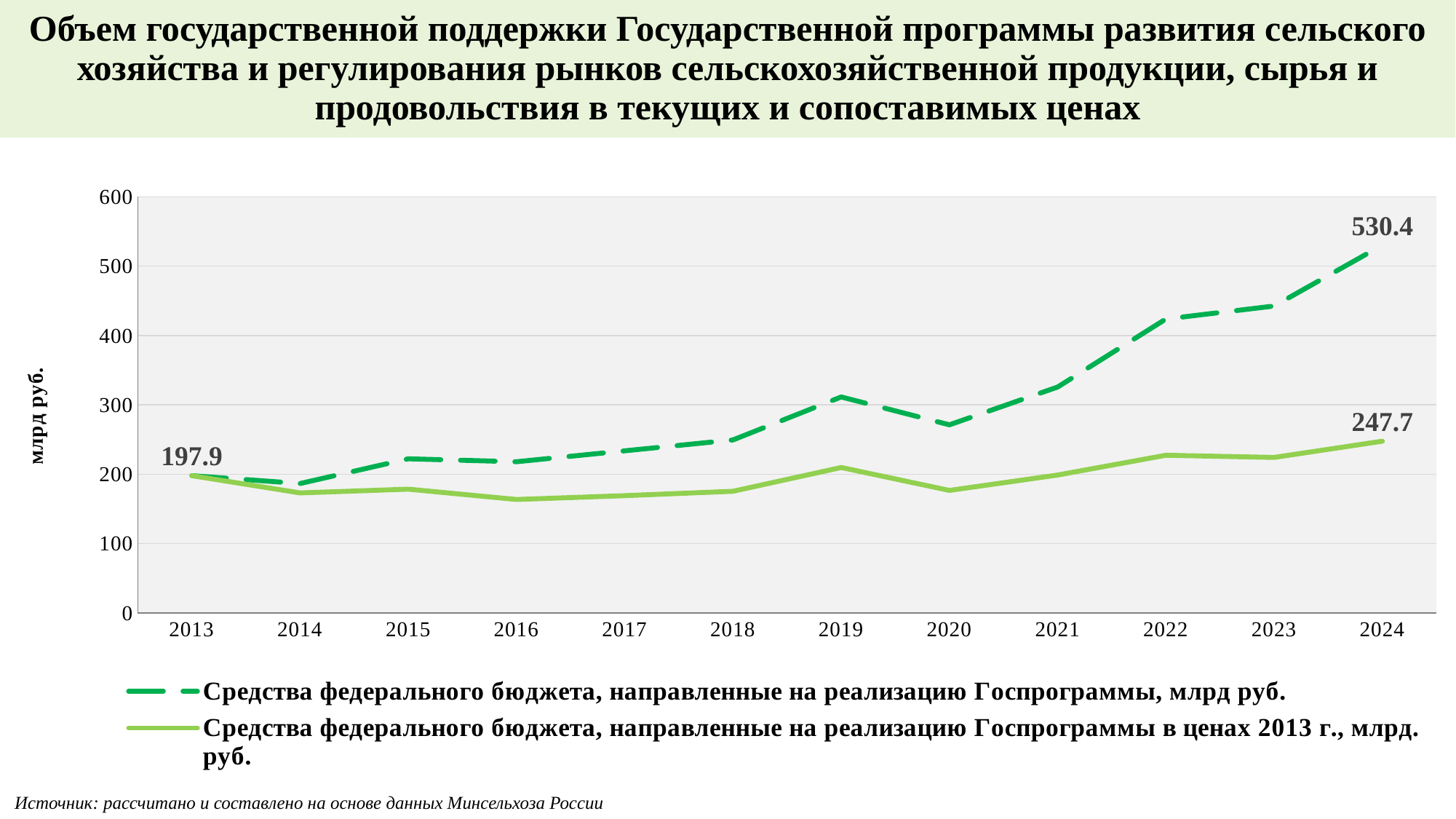
In which year does the dashed line (current prices) reach its highest value? 2024 By how much did the federal budget funds in current prices (dashed line) grow from 2013 to 2024? 332.5 What is the value of the federal budget funds in 2013 prices (solid line) in 2024? 247.7 What is the difference between the two series' values in 2024? 282.7 What is the value of the federal budget funds in current prices (dashed line) in 2024? 530.4 What is the label on the vertical axis? млрд руб. What kind of chart is shown on the slide? line chart How many years are shown on the x axis? 12 Is the value of the dashed line (current prices) in 2022 greater or less than 400? greater Is the value of the solid line (2013 prices) in 2020 greater or less than 200? less How many series does the legend list? 2 What is the value shown for 2013? 197.9